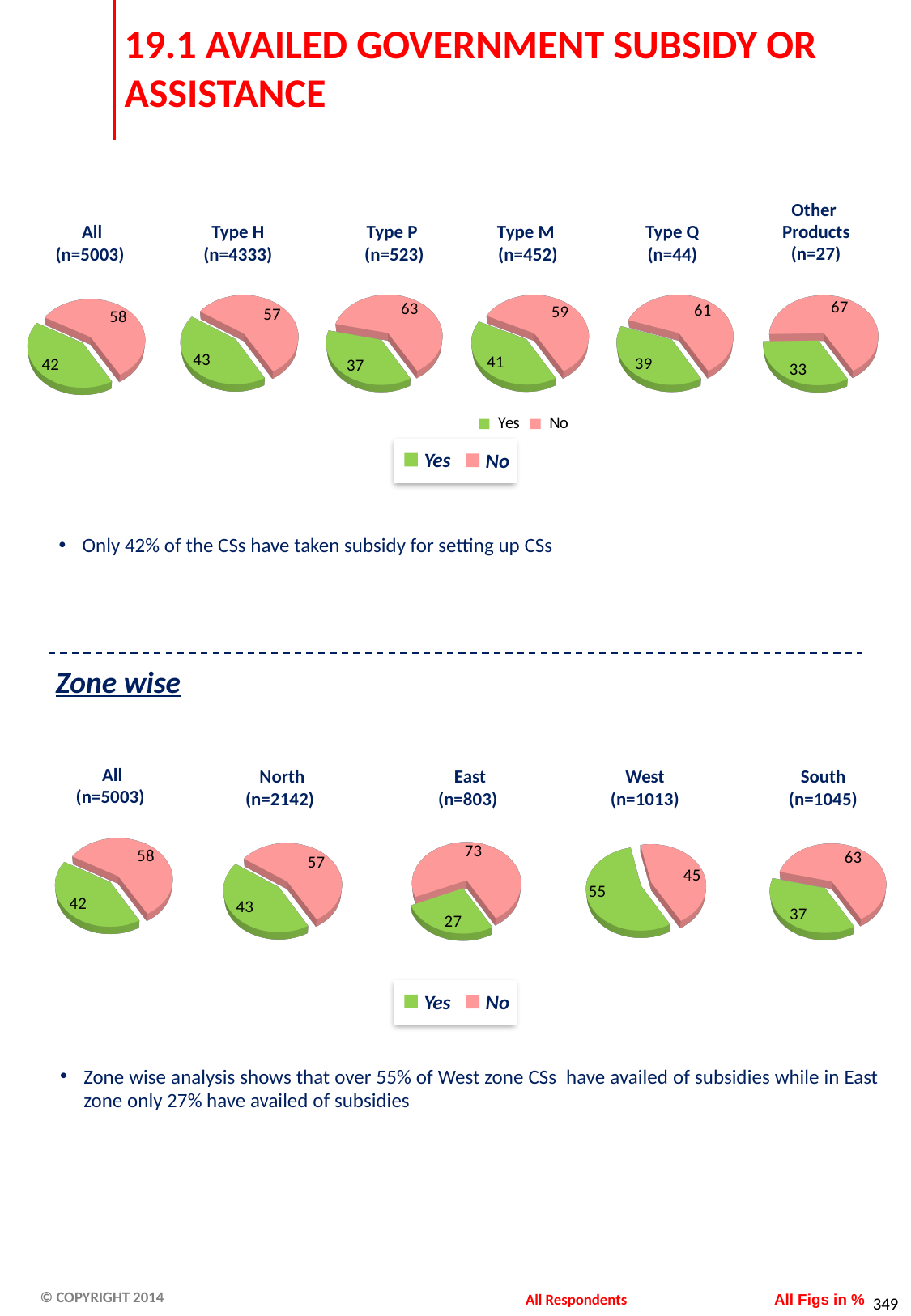
Among the Zone wise pie charts, which zone has the highest 'Yes' value? West In the Zone wise row, what is the difference between the 'No' value for East and the 'No' value for West? 28 How many pie charts are in the Zone wise row? 5 In the Zone wise row of pie charts, what is the 'Yes' value for the West (n=1013) pie? 55 How many entries does the legend below the Zone wise pie charts list? 2 Among the Zone wise pie charts, which zone has the lowest 'Yes' value? East In the top row of pie charts, is the 'Yes' value for Type H larger or smaller than the 'Yes' value for Type Q? larger In the top row of pie charts, what is the 'Yes' value for the All (n=5003) pie? 42 In the top row of pie charts, what is the 'No' value for the Type P (n=523) pie? 63 In the top row of pie charts, which category has the highest 'No' value? Other Products In the top row of pie charts, what is the 'Yes' value for the Other Products (n=27) pie? 33 In the Zone wise row of pie charts, what is the 'No' value for the East (n=803) pie? 73